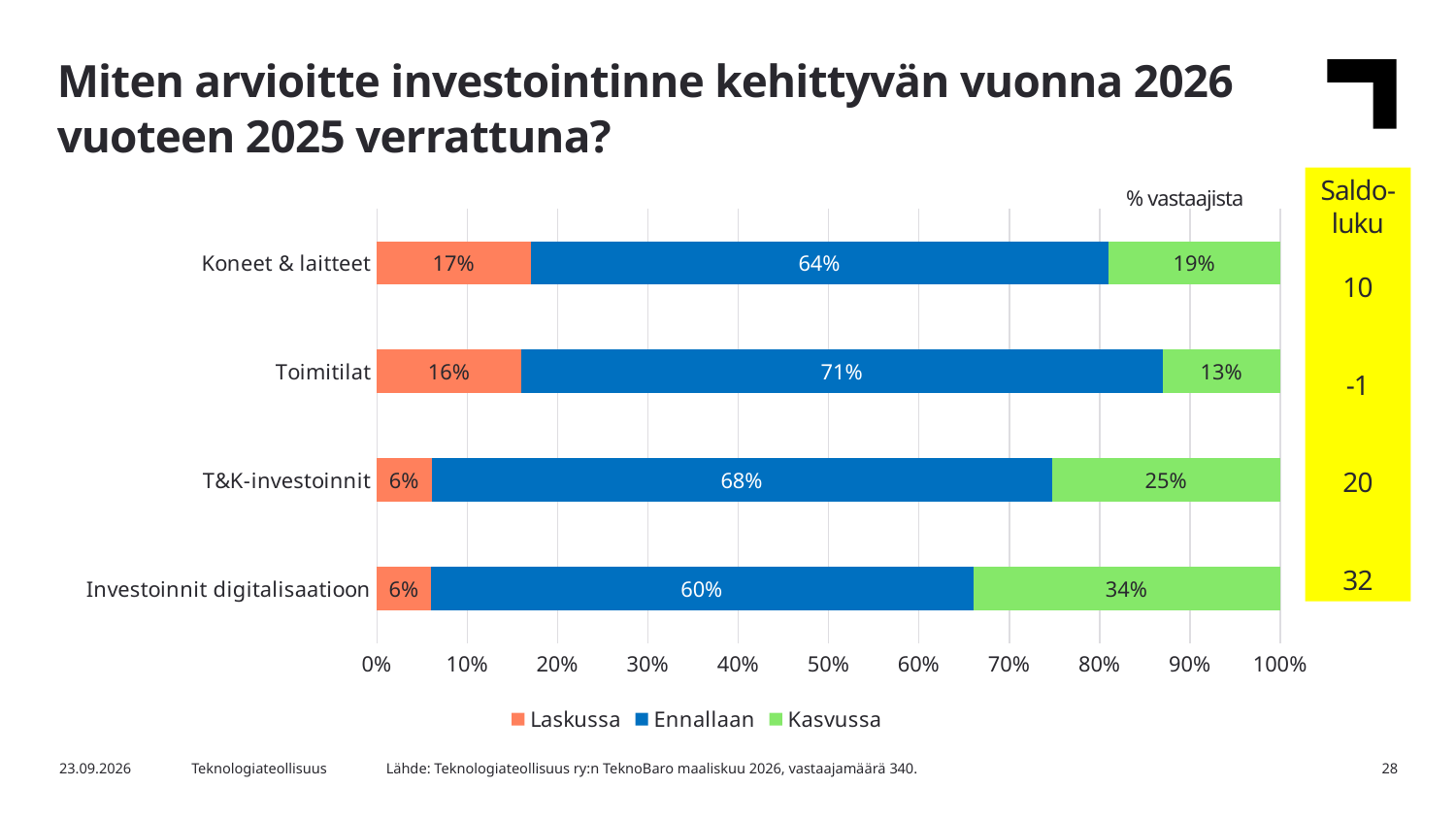
Which category has the highest Ennallaan share? Toimitilat What is the Laskussa value for Toimitilat? 16% What percentage of respondents expect Koneet & laitteet investments to be Ennallaan? 64% Is the Laskussa share larger for Koneet & laitteet or for T&K-investoinnit? Koneet & laitteet How many series does the legend list? 3 What is the Saldoluku value shown for T&K-investoinnit? 20 What kind of chart is shown on the slide? Stacked bar chart What is the Kasvussa value for Investoinnit digitalisaatioon? 34% Which category has the highest Kasvussa share? Investoinnit digitalisaatioon Which category has the lowest Kasvussa share? Toimitilat What is the difference between the Kasvussa values for Investoinnit digitalisaatioon and T&K-investoinnit? 9% How many categories are shown on the chart? 4